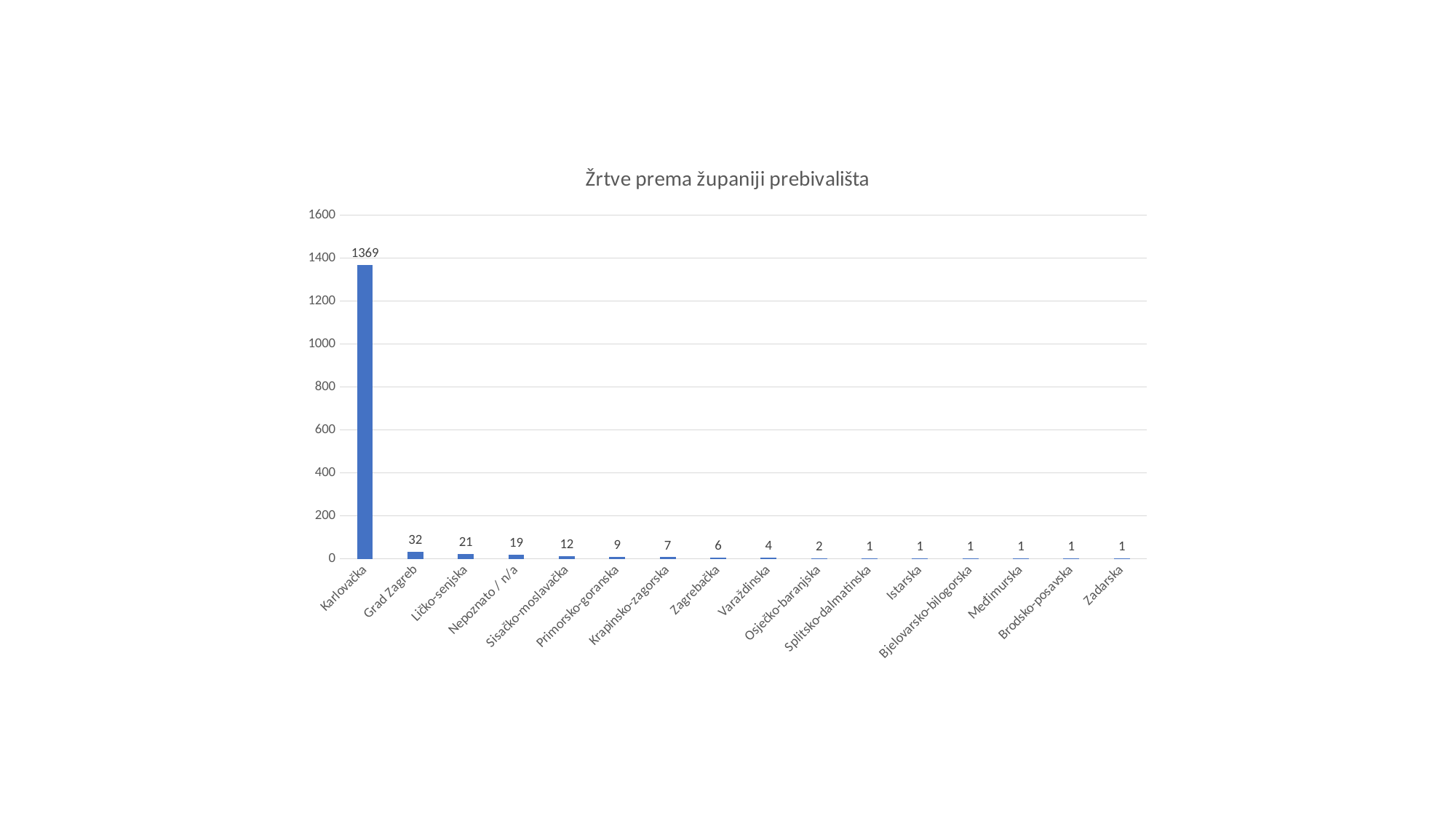
What kind of chart is this? bar chart What is the value for Grad Zagreb? 32 What is the value for Sisačko-moslavačka? 12 Is the value for Karlovačka greater or less than 1200? greater How many categories are shown on the x axis? 16 What is the value for Ličko-senjska? 21 What is the difference between the values for Nepoznato / n/a and Primorsko-goranska? 10 What is the difference between the values for Karlovačka and Grad Zagreb? 1337 Which category has the highest value? Karlovačka Which is larger, the value for Krapinsko-zagorska or the value for Zagrebačka? Krapinsko-zagorska What is the value for Varaždinska? 4 What is the value for Karlovačka? 1369